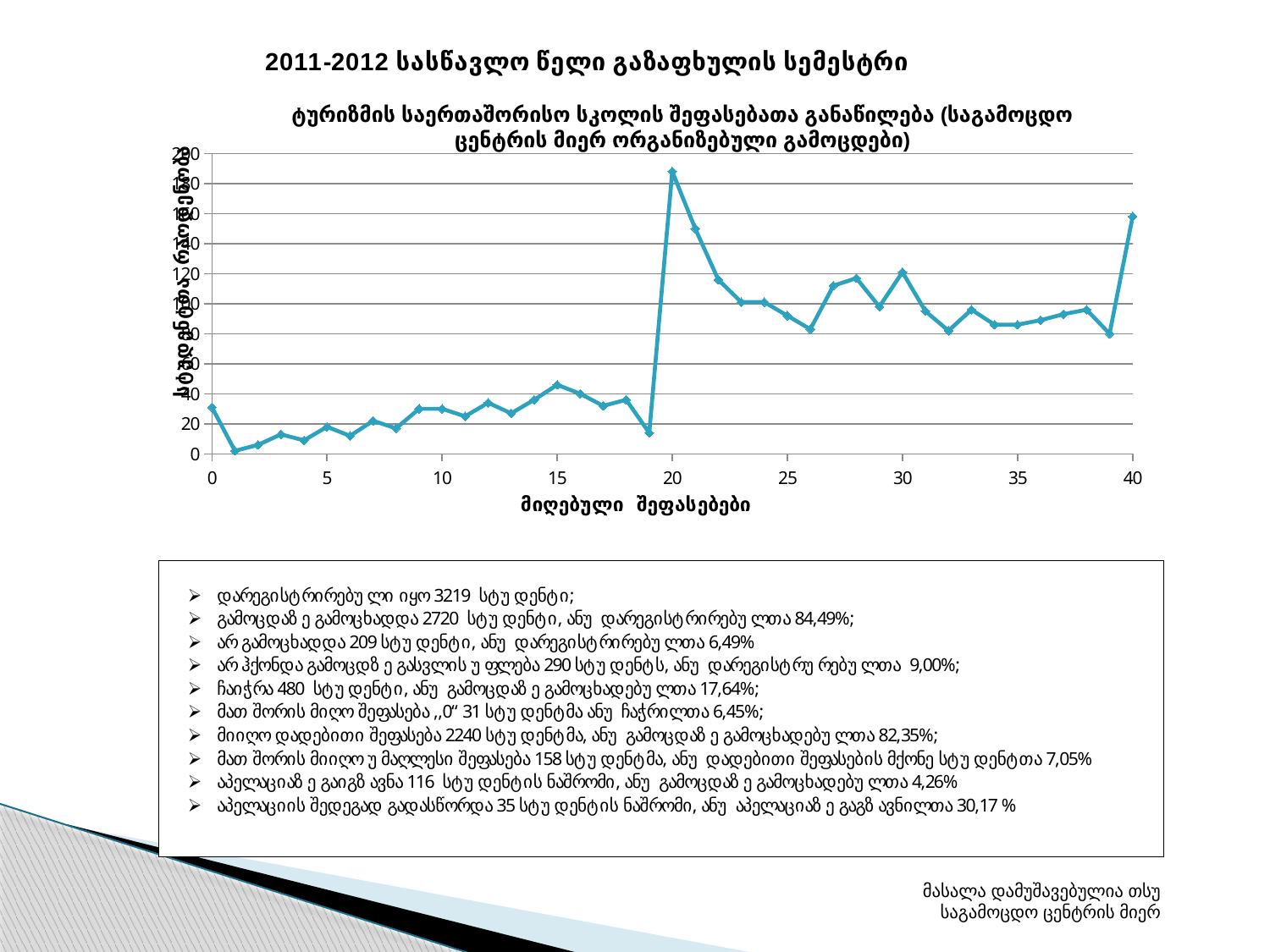
At which x-axis value (score) does the line reach its highest point? 20 Is the value at x = 19 greater or less than 20? less Which has the larger value, x = 30 or x = 26? x = 30 Do the values rise or fall along the x axis from x = 20 to x = 26? fall Is the value at x = 20 greater or less than 160? greater At which x-axis value (score) does the line reach its lowest point? 1 What kind of chart is shown on the slide? line chart Is the value at x = 0 greater or less than 20? greater Which has the larger value, x = 20 or x = 21? x = 20 What is the title of the x axis? მიღებული შეფასებები